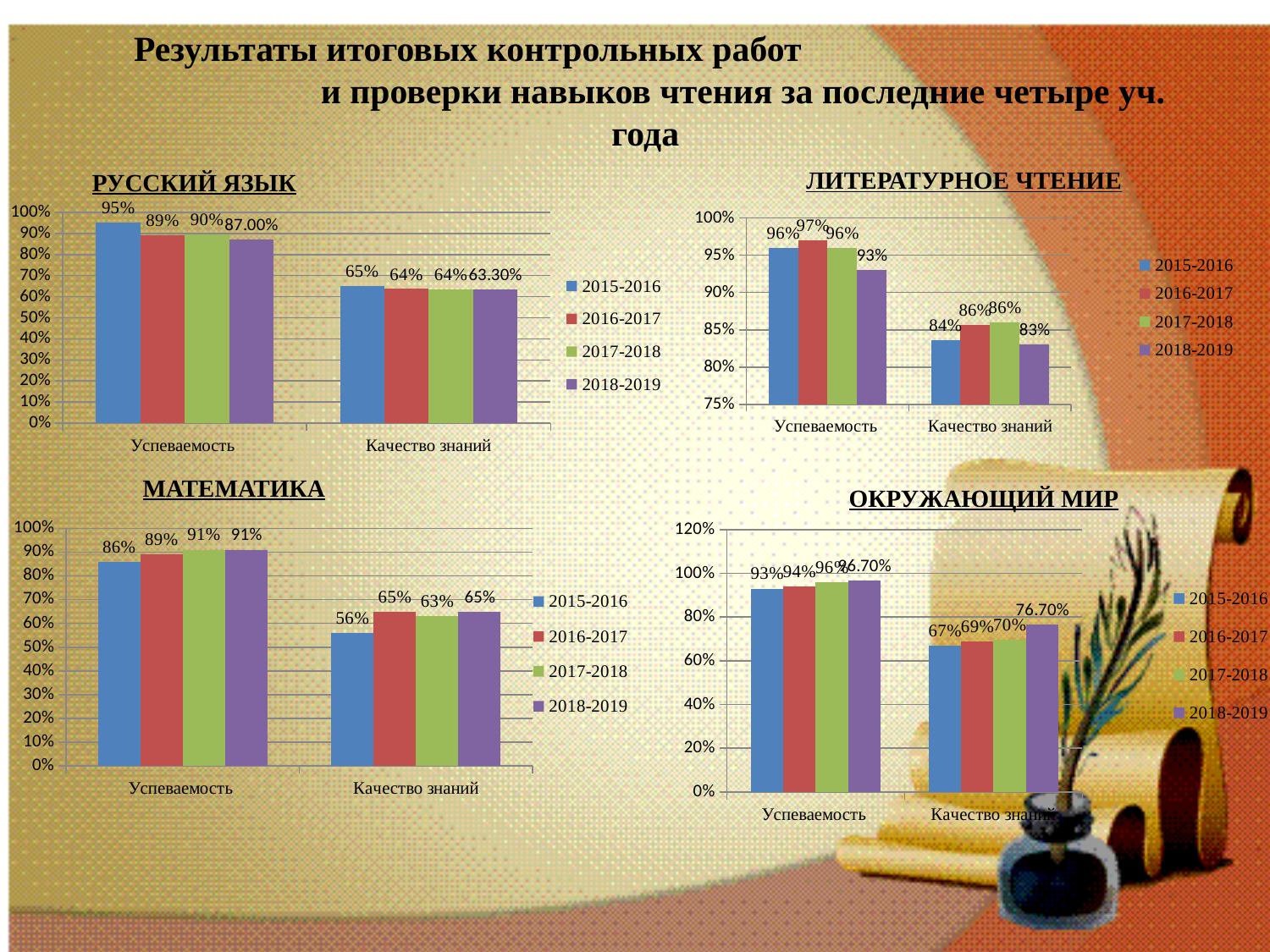
In the ЛИТЕРАТУРНОЕ ЧТЕНИЕ chart, which year has the highest value for Успеваемость? 2016-2017 In the ОКРУЖАЮЩИЙ МИР chart, what is the value for Качество знаний in 2018-2019? 76.70% In the РУССКИЙ ЯЗЫК chart, what is the value for Качество знаний in 2018-2019? 63.30% In the МАТЕМАТИКА chart, which year has the lowest value for Качество знаний? 2015-2016 In the ОКРУЖАЮЩИЙ МИР chart, do the Успеваемость values rise or fall from 2015-2016 to 2018-2019? Rise In the ЛИТЕРАТУРНОЕ ЧТЕНИЕ chart, what is the value for Качество знаний in 2018-2019? 83% In the ОКРУЖАЮЩИЙ МИР chart, which is larger: Успеваемость in 2015-2016 or Успеваемость in 2018-2019? 2018-2019 How many categories are shown on the x axis of the РУССКИЙ ЯЗЫК chart? 2 What kind of chart is the ОКРУЖАЮЩИЙ МИР chart? Bar chart In the РУССКИЙ ЯЗЫК chart, what is the value for Успеваемость in 2015-2016? 95% In the МАТЕМАТИКА chart, what is the difference between Успеваемость and Качество знаний in 2015-2016? 30% How many series does the legend of the МАТЕМАТИКА chart list? 4